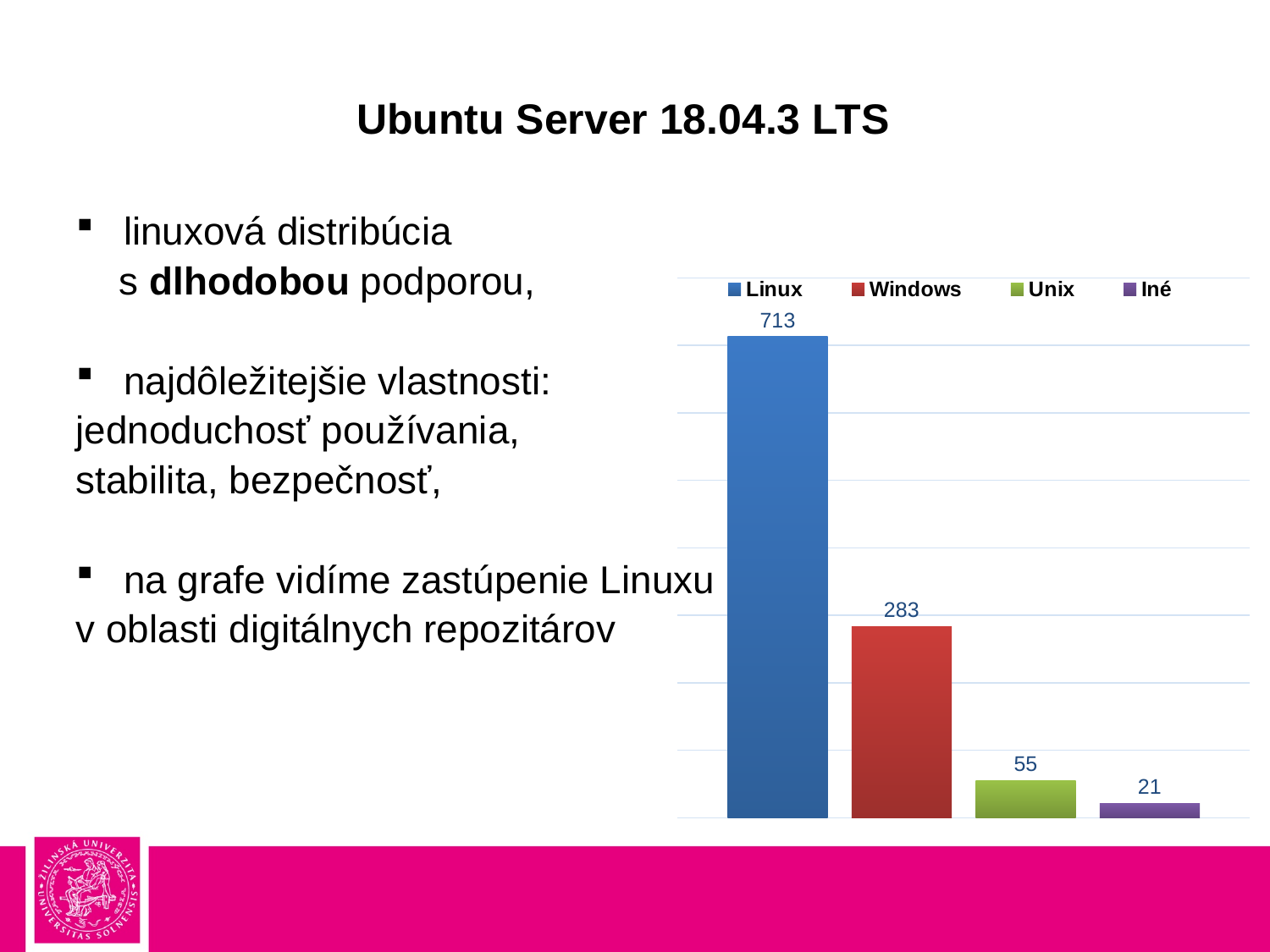
How many entries does the legend list? 4 What is the difference between the values for Unix and Iné? 34 What kind of chart is shown on the slide? bar chart What is the value for Unix? 55 Which category has the highest value? Linux What is the value for Windows? 283 How many categories are shown in the chart? 4 Which is larger, the value for Windows or the value for Unix? Windows Which category has the lowest value? Iné What is the difference between the values for Linux and Windows? 430 What is the value for Iné? 21 What is the value for Linux? 713